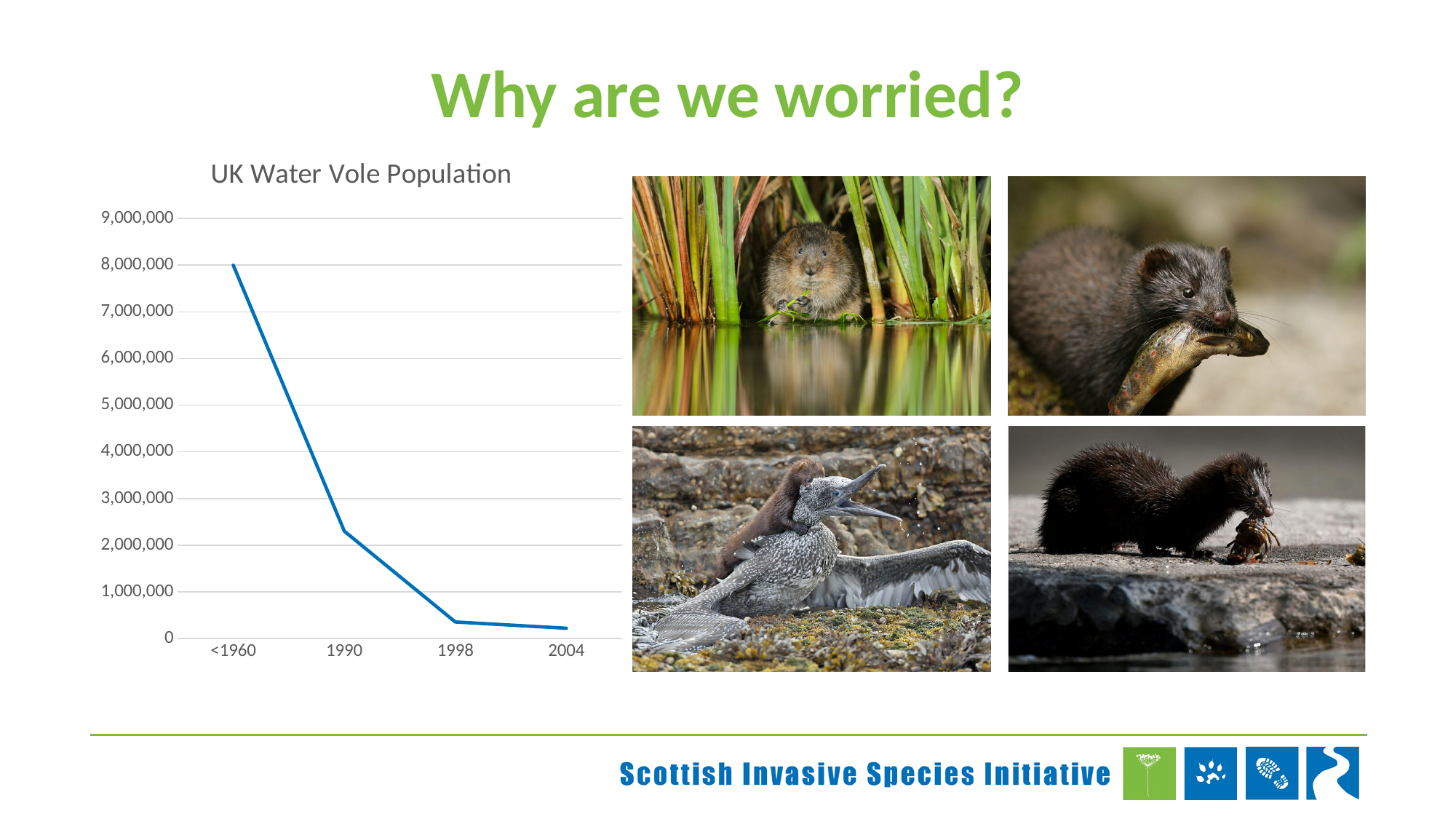
What kind of chart is the UK Water Vole Population chart? line chart Is the UK water vole population for 1990 greater or less than 3,000,000? less Is the UK water vole population for 1998 greater or less than 1,000,000? less What is the title of the chart on the slide? UK Water Vole Population What is the highest value shown on the y axis of the UK Water Vole Population chart? 9,000,000 How many time points are plotted on the UK Water Vole Population chart? 4 Which time point has the highest UK water vole population? <1960 Does the UK water vole population rise or fall from <1960 to 2004? fall What is the UK water vole population shown for <1960? 8,000,000 Which is larger, the UK water vole population in 1990 or in 1998? 1990 Which time point has the lowest UK water vole population? 2004 Is the UK water vole population for 1990 greater or less than 2,000,000? greater